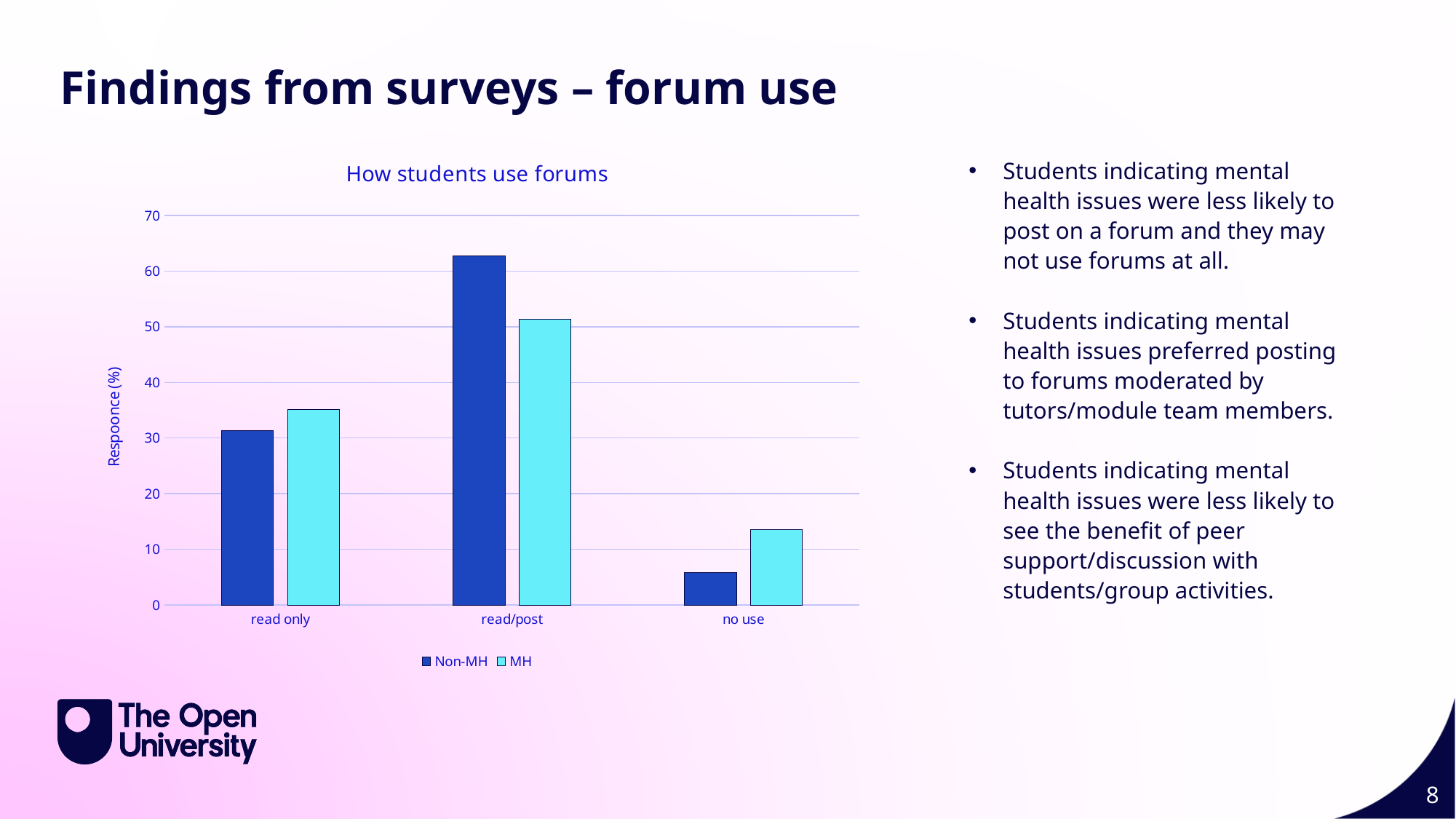
For no use, which series has the larger value, Non-MH or MH? MH Is the MH value for read only greater or less than 40? less What is the label on the y axis of the chart? Respoonce (%) How many categories are shown on the x axis? 3 Which category has the highest Non-MH value? read/post Which category has the lowest MH value? no use Is the Non-MH value for no use greater or less than 10? less Is the Non-MH value for read/post greater or less than 60? greater What is the title of the chart? How students use forums How many series does the legend list? 2 What kind of chart is shown on the slide? bar chart For read/post, which series has the larger value, Non-MH or MH? Non-MH